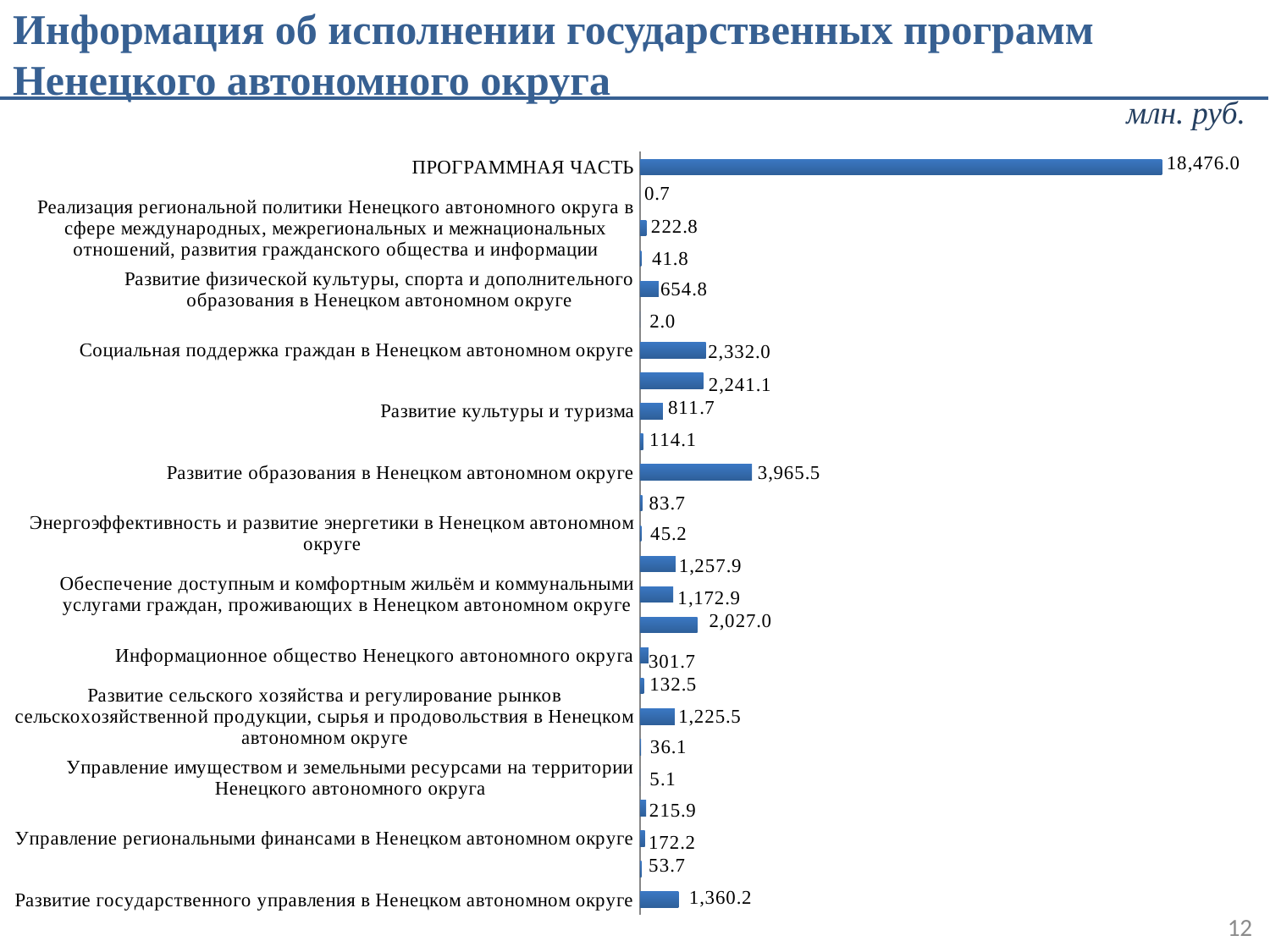
What is the value for ПРОГРАММНАЯ ЧАСТЬ? 18,476.0 What is the value for Социальная поддержка граждан в Ненецком автономном округе? 2,332.0 In what units are the values on the chart expressed? млн. руб. What is the value for Развитие государственного управления в Ненецком автономном округе? 1,360.2 What is the value for Развитие образования в Ненецком автономном округе? 3,965.5 What is the value for Информационное общество Ненецкого автономного округа? 301.7 What type of chart is shown on the slide? bar chart Which is larger: Развитие образования в Ненецком автономном округе or Социальная поддержка граждан в Ненецком автономном округе? Развитие образования в Ненецком автономном округе Which category has the highest value on the chart? ПРОГРАММНАЯ ЧАСТЬ What is the value for Развитие культуры и туризма? 811.7 What is the difference between Социальная поддержка граждан в Ненецком автономном округе (2,332.0) and Развитие культуры и туризма (811.7)? 1,520.3 What is the smallest value printed on the chart? 0.7